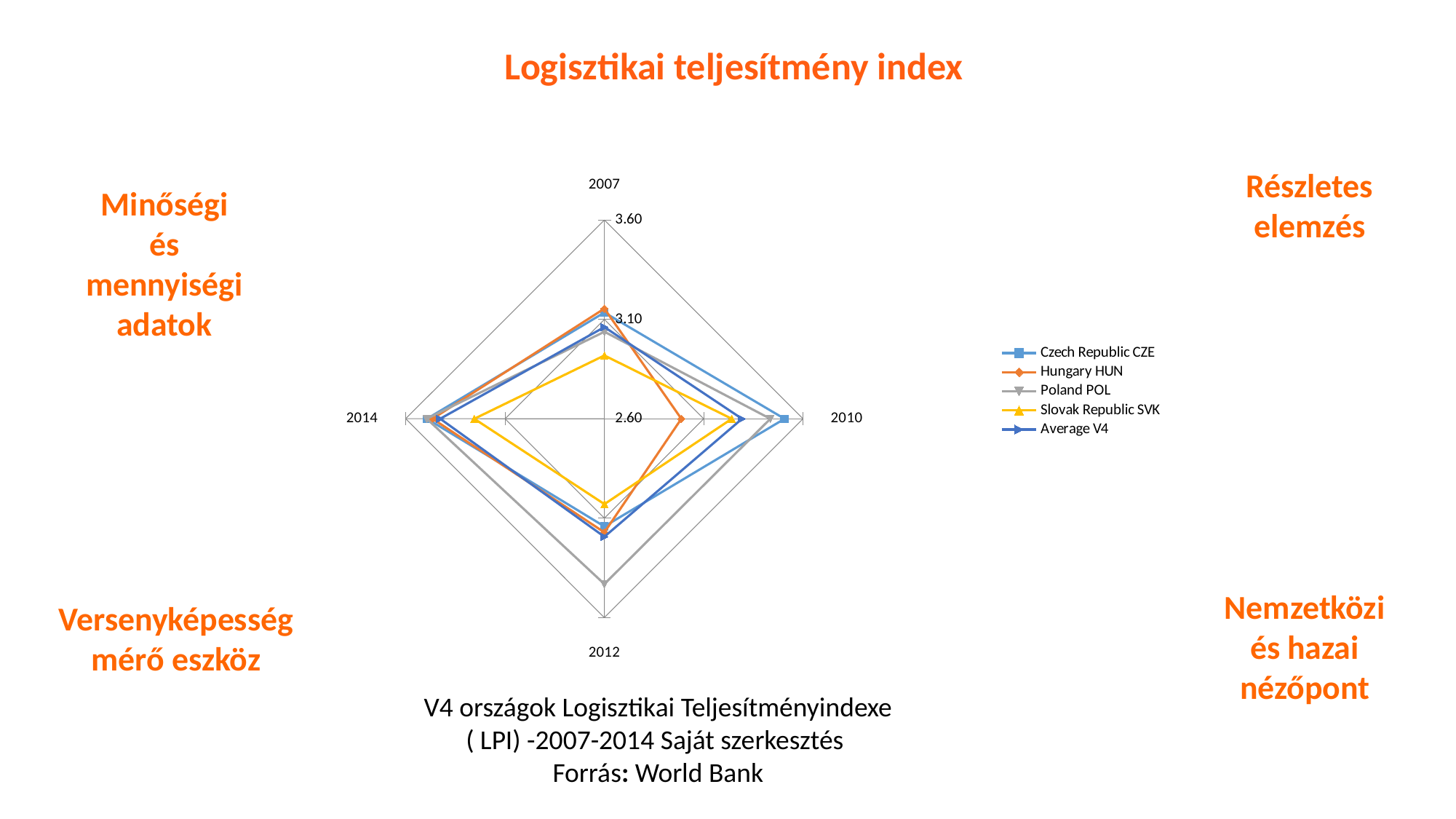
Is the value for Hungary HUN in 2010 greater or less than 3.10? less How many series does the legend list? 5 How many year categories (axes) does the radar chart have? 4 Which series is drawn in yellow with triangle markers? Slovak Republic SVK Is the value for Slovak Republic SVK in 2007 greater or less than 3.10? less Which series has the lowest value for 2007? Slovak Republic SVK What kind of chart is shown on the slide? Radar chart Is the value for Poland POL in 2012 greater or less than 3.10? greater Which series has the highest value for 2012? Poland POL Which series has the lowest value for 2010? Hungary HUN Which series has the lowest value for 2014? Slovak Republic SVK